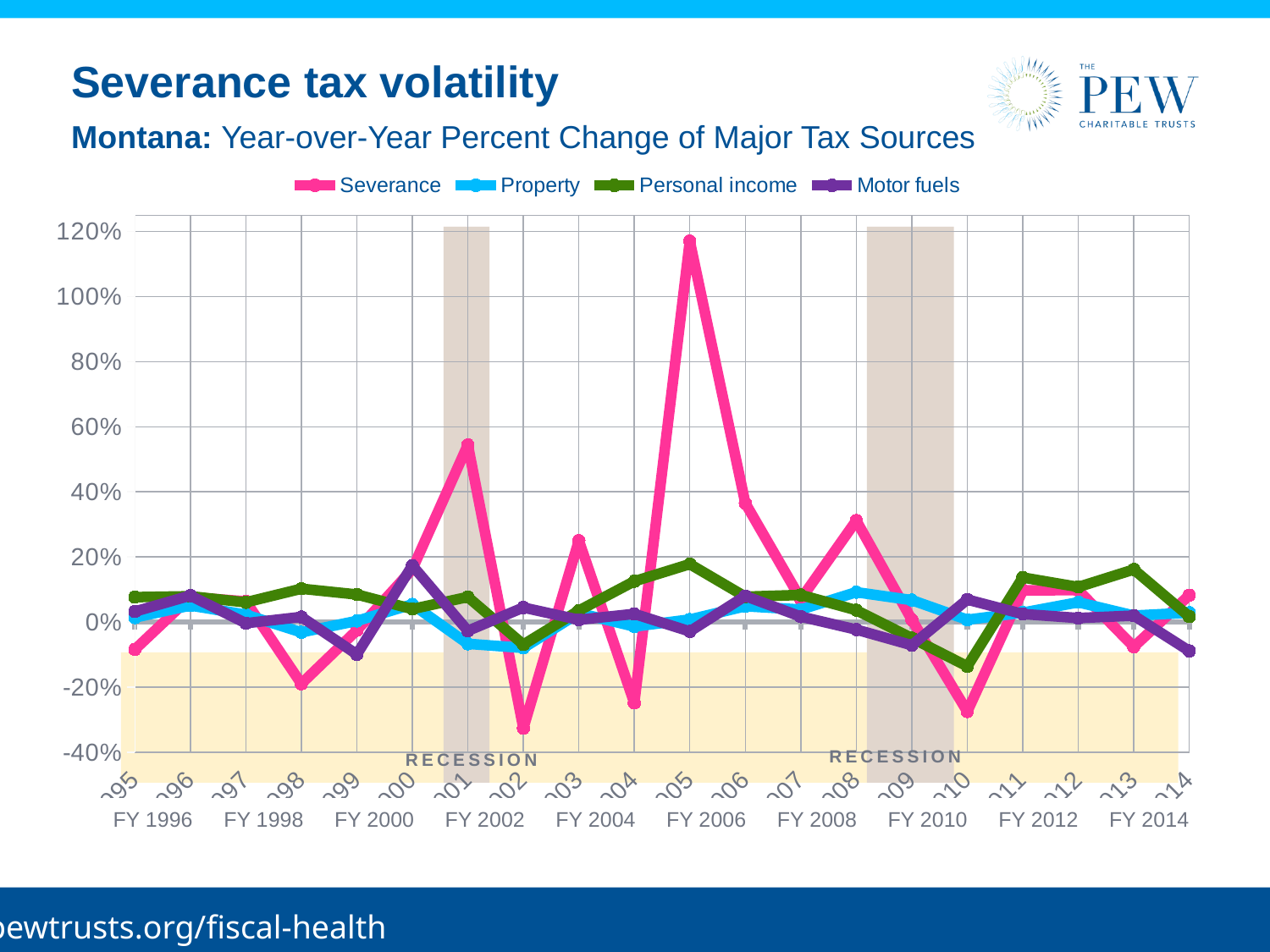
Is the value for Severance in FY 2002 greater or less than -20%? less Is the value for Severance in FY 2001 greater or less than 40%? greater Which series reaches the highest value on the chart? Severance In FY 2010, which is larger: the value for Property or the value for Severance? Property In FY 2005, which is larger: the value for Severance or the value for Personal income? Severance Which state does the chart subtitle say the data is for? Montana Which series are listed in the legend? Severance, Property, Personal income, Motor fuels Is the value for Personal income in FY 2010 greater or less than 0%? less How many series does the legend list? 4 What kind of chart is shown on the slide? Line chart